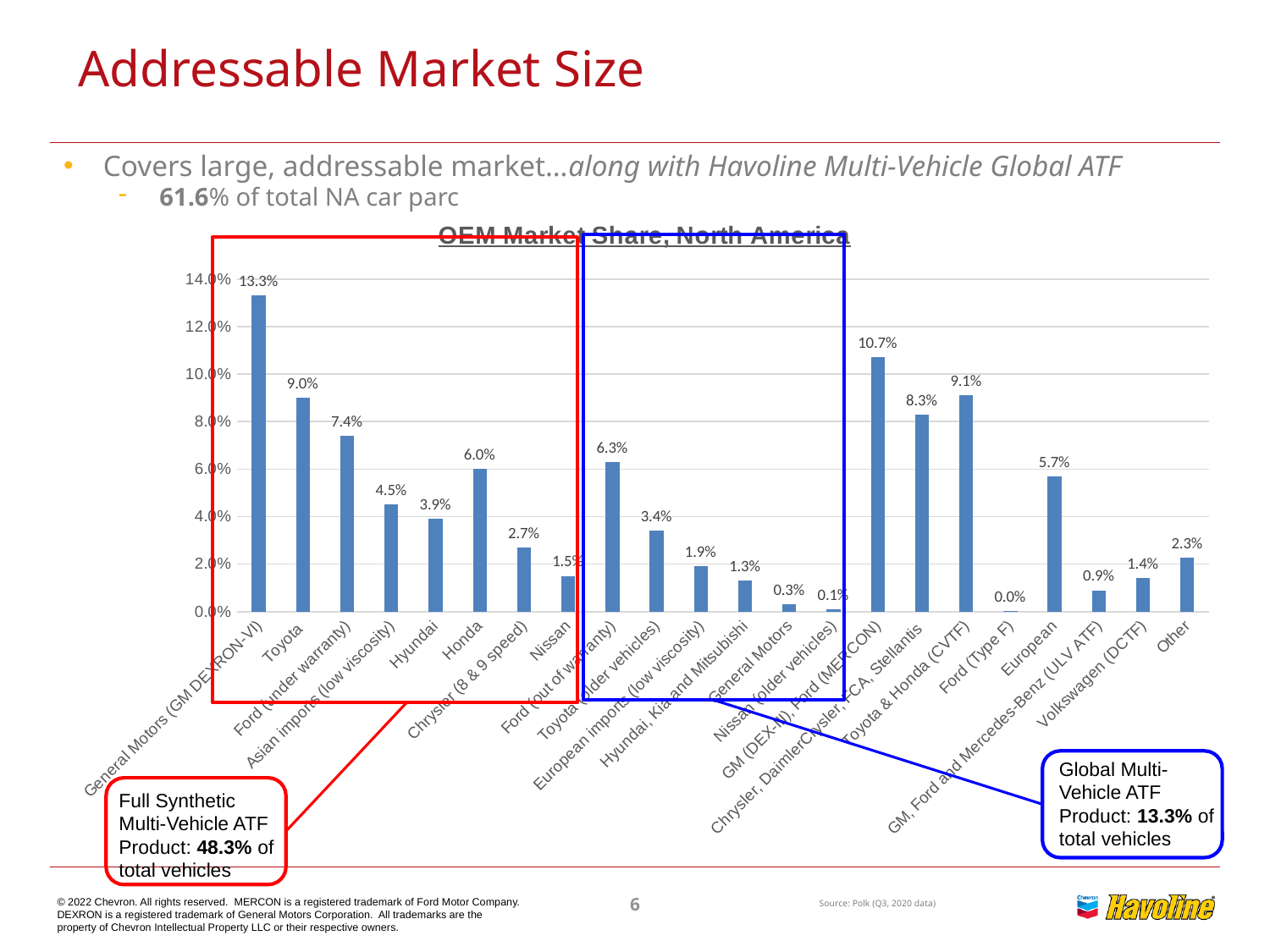
What is the title of the chart? OEM Market Share, North America Which category has the highest market share? General Motors (GM DEXRON-VI) Which category has the lowest market share? Ford (Type F) What is the difference between the market share of Toyota and Hyundai? 5.1% What is the market share value for Toyota? 9.0% What is the market share value for Honda? 6.0% What is the market share value for GM (DEX-III), Ford (MERCON)? 10.7% What is the market share value for Other? 2.3% What is the market share value for Volkswagen (DCTF)? 1.4% What kind of chart is shown on the slide? bar chart Which has a larger market share: Toyota & Honda (CVTF) or Chrysler, DaimlerChrysler, FCA, Stellantis? Toyota & Honda (CVTF) How many categories are plotted in the chart? 22